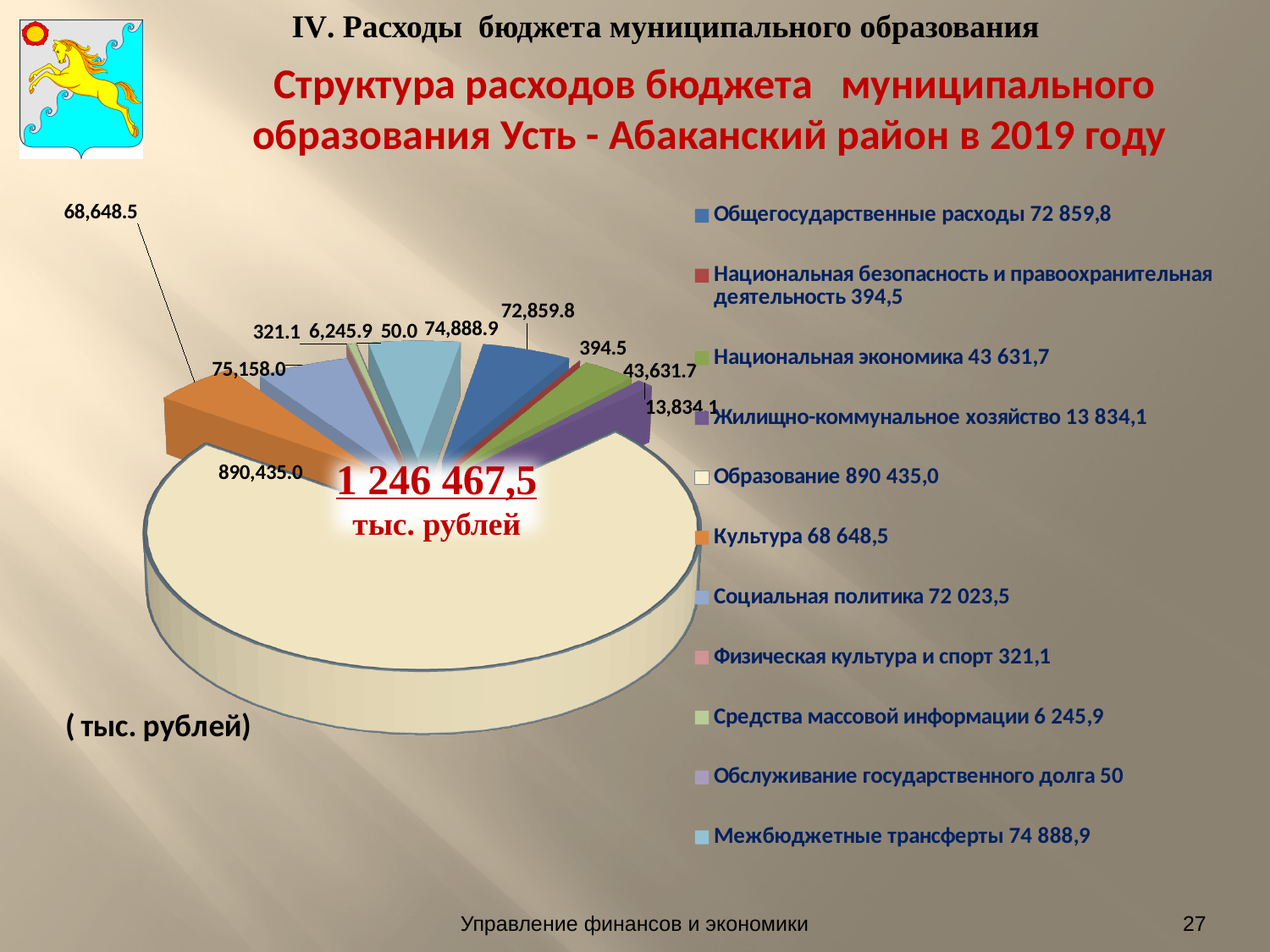
How many categories does the pie chart have? 11 What unit is indicated below the pie chart on the left? ( тыс. рублей) What is the value for Образование according to the legend? 890 435,0 What is the difference between Общегосударственные расходы (72 859,8) and Культура (68 648,5)? 4 211,3 What total value is printed in the centre of the pie chart? 1 246 467,5 тыс. рублей Which category has the smallest value in the pie chart? Обслуживание государственного долга Which is larger: Общегосударственные расходы or Культура? Общегосударственные расходы What is the value for Национальная экономика according to the legend? 43 631,7 What kind of chart is shown on the slide? pie chart What is the value for Межбюджетные трансферты according to the legend? 74 888,9 What is the value for Жилищно-коммунальное хозяйство according to the legend? 13 834,1 Which category has the largest slice of the pie chart? Образование